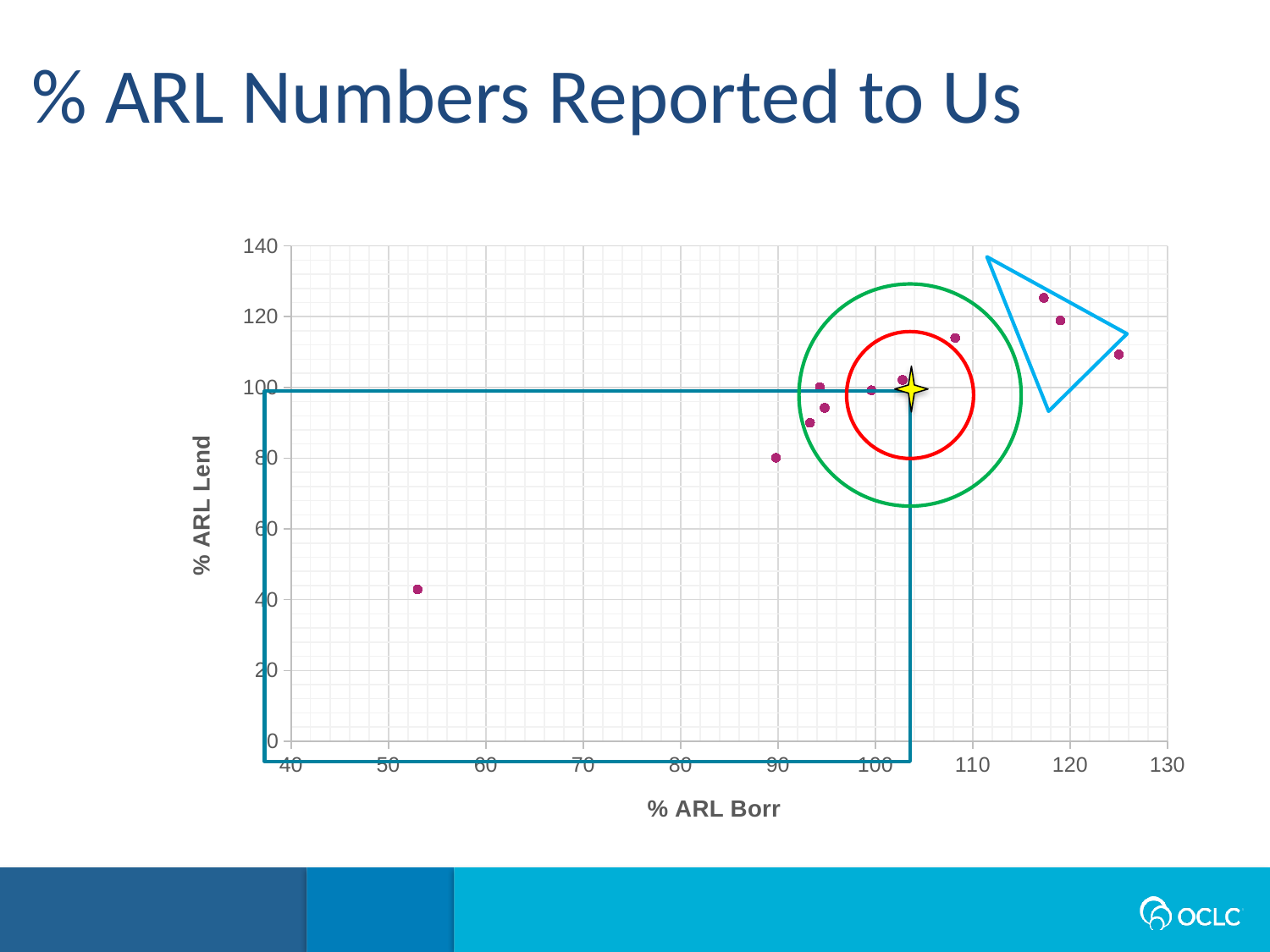
Is the % ARL Borr value of the rightmost point on the chart greater or less than 120? greater What is the highest value shown on the vertical axis? 140 What kind of chart is shown on the slide? scatter chart What is the lowest value shown on the horizontal axis? 40 What is the highest value shown on the horizontal axis? 130 What is the title of the chart? % ARL Numbers Reported to Us Is the % ARL Lend value of the highest point on the chart greater or less than 120? greater Do most of the plotted points have a % ARL Borr value greater or less than 80? greater Is the point with the lowest % ARL Lend value also the point with the lowest % ARL Borr value? yes What is the label of the vertical axis? % ARL Lend